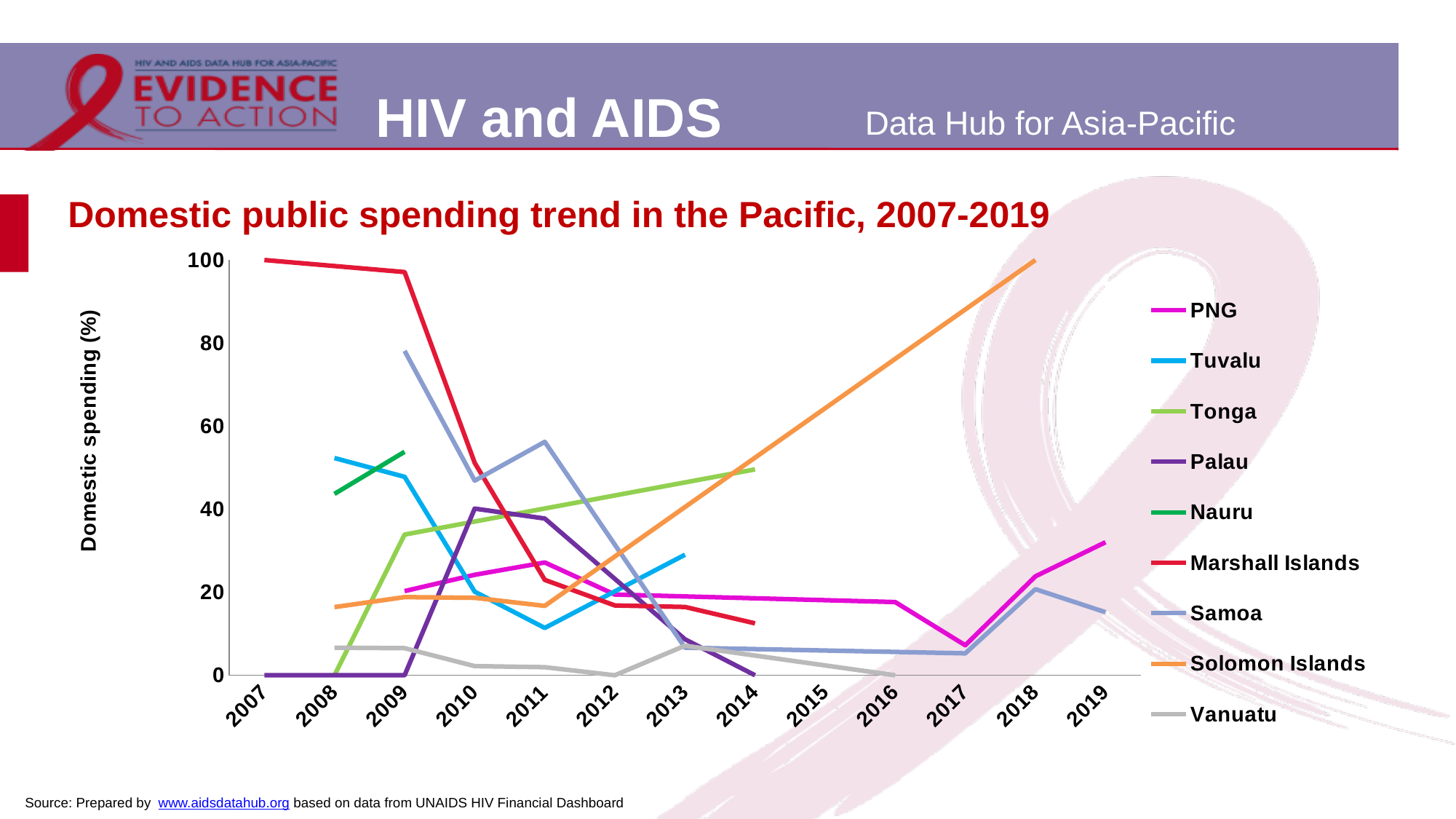
What kind of chart is shown on the slide? line chart What is the title of the y axis? Domestic spending (%) How many years are shown on the x axis? 13 Is the value for Samoa in 2009 greater or less than 60? greater What is the domestic spending value for Palau in 2007? 0 What is the domestic spending value for Marshall Islands in 2007? 100 Which series has the highest value in 2009? Marshall Islands Does the Marshall Islands line rise or fall from 2007 to 2014? fall How many series does the legend list? 9 Is the value for PNG in 2019 greater or less than 20? greater Is the value for Tuvalu in 2011 greater or less than 20? less